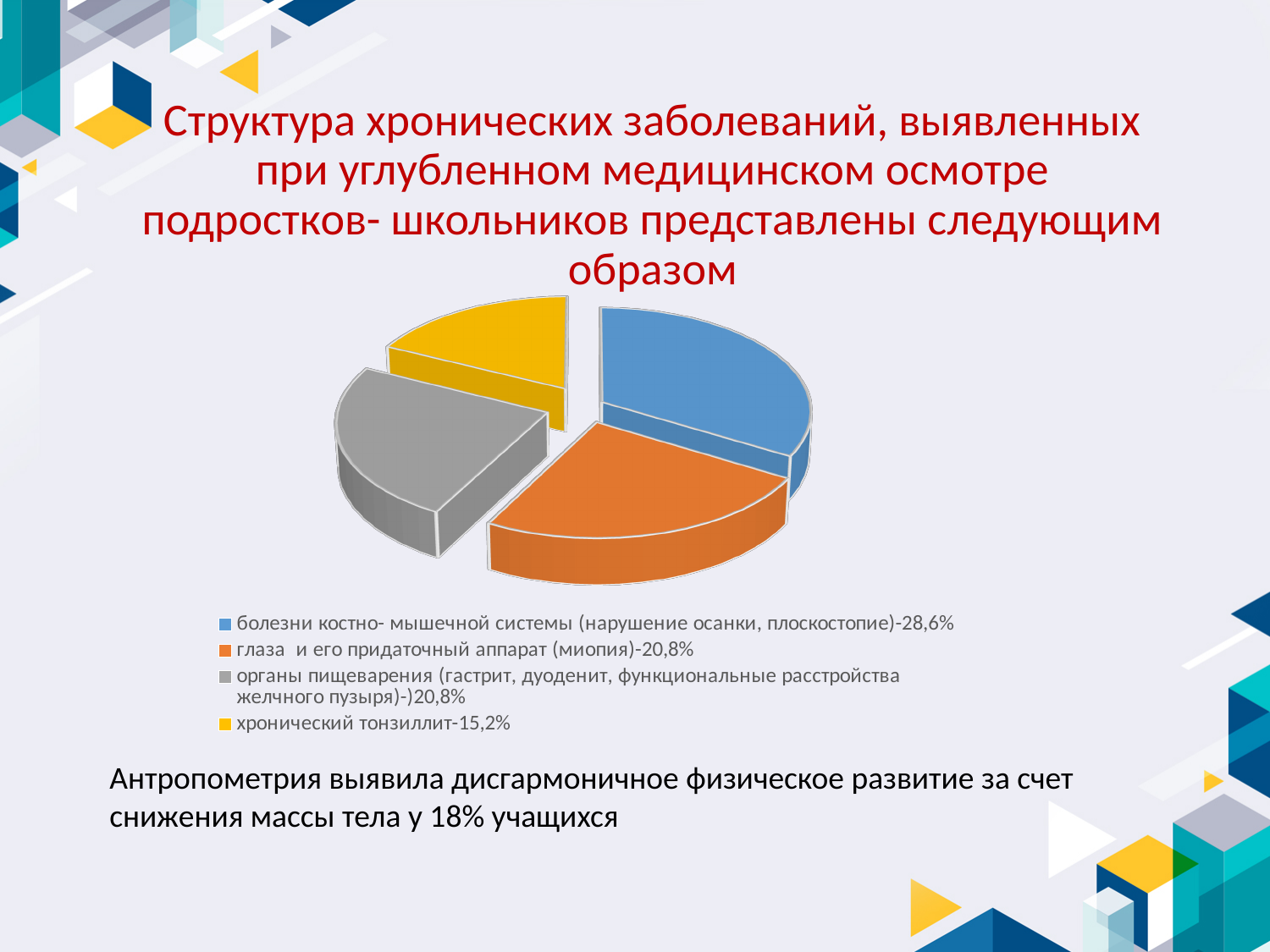
Which category has the smallest share of the pie? хронический тонзиллит What percentage is shown for глаза и его придаточный аппарат (миопия)? 20,8% What kind of chart is shown on the slide? pie chart How many slices does the pie chart have? 4 What colour is the slice for болезни костно-мышечной системы? blue What percentage is shown for хронический тонзиллит? 15,2% What is the difference between the share for болезни костно-мышечной системы and the share for хронический тонзиллит? 13,4% What colour is the slice for хронический тонзиллит? yellow What percentage is shown for органы пищеварения (гастрит, дуоденит, функциональные расстройства желчного пузыря)? 20,8% Which category has the largest share of the pie? болезни костно-мышечной системы (нарушение осанки, плоскостопие) Which is larger: the share for глаза и его придаточный аппарат (миопия) or the share for хронический тонзиллит? глаза и его придаточный аппарат (миопия) What share of chronic diseases is attributed to болезни костно-мышечной системы (нарушение осанки, плоскостопие)? 28,6%